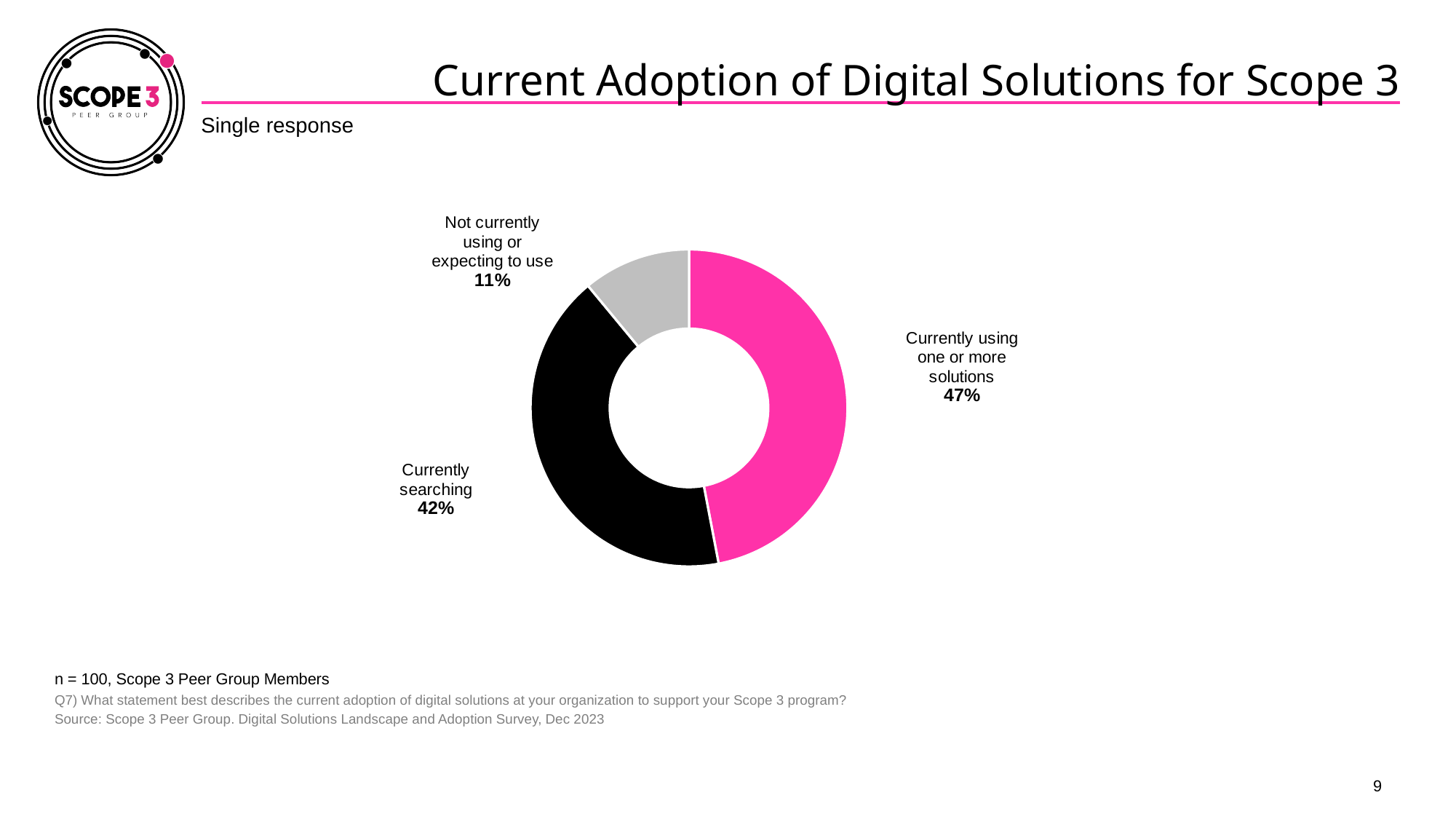
Which category has the smallest share of the chart? Not currently using or expecting to use What percentage of respondents are currently searching? 42% What is the difference in percentage points between 'Currently using one or more solutions' and 'Currently searching'? 5 What percentage of respondents are currently using one or more solutions? 47% Which category has the largest share of the chart? Currently using one or more solutions Which is larger: the share for 'Currently searching' or the share for 'Not currently using or expecting to use'? Currently searching What kind of chart is shown on the slide? Doughnut chart What colour is the 'Currently searching' segment of the chart? Black What is the title of the chart on the slide? Current Adoption of Digital Solutions for Scope 3 What percentage of respondents are not currently using or expecting to use digital solutions? 11% What is the difference in percentage points between 'Currently searching' and 'Not currently using or expecting to use'? 31 How many categories are shown in the chart? 3